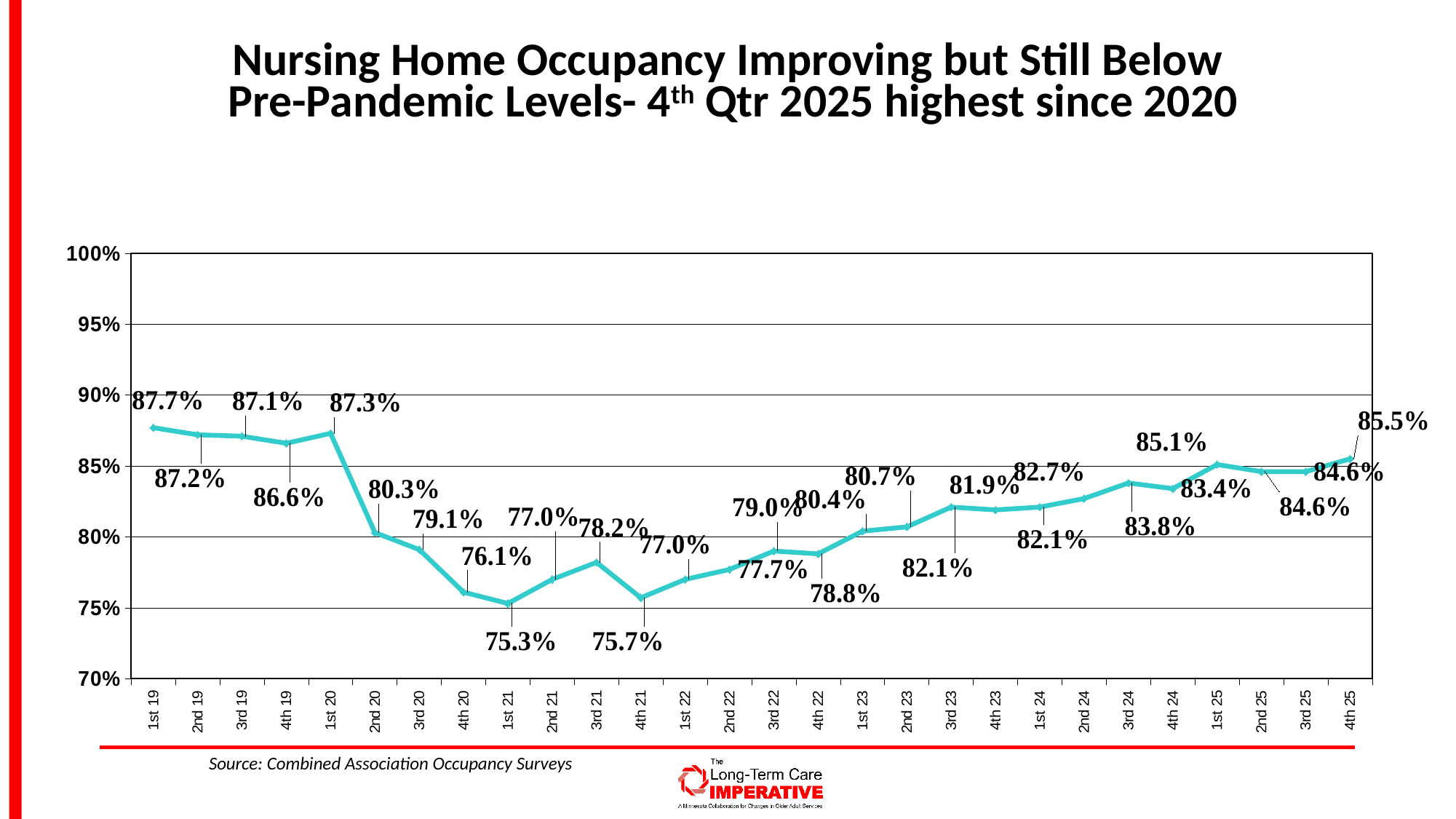
What is the occupancy value for 1st 21? 75.3% Which quarter has the highest occupancy value? 1st 19 Which quarter has the lowest occupancy value? 1st 21 Is the value for 2nd 20 greater or less than 85%? less What is the difference between the occupancy in 1st 19 and in 4th 25? 2.2 percentage points How many quarterly data points are plotted on the chart? 28 What is the occupancy value for 2nd 20? 80.3% What kind of chart is shown on the slide? line chart What source is cited below the chart? Combined Association Occupancy Surveys What is the occupancy value for 4th 25? 85.5% Do the occupancy values generally rise or fall from 1st 21 to 4th 25? rise Which is larger, the occupancy in 1st 25 or in 4th 25? 4th 25